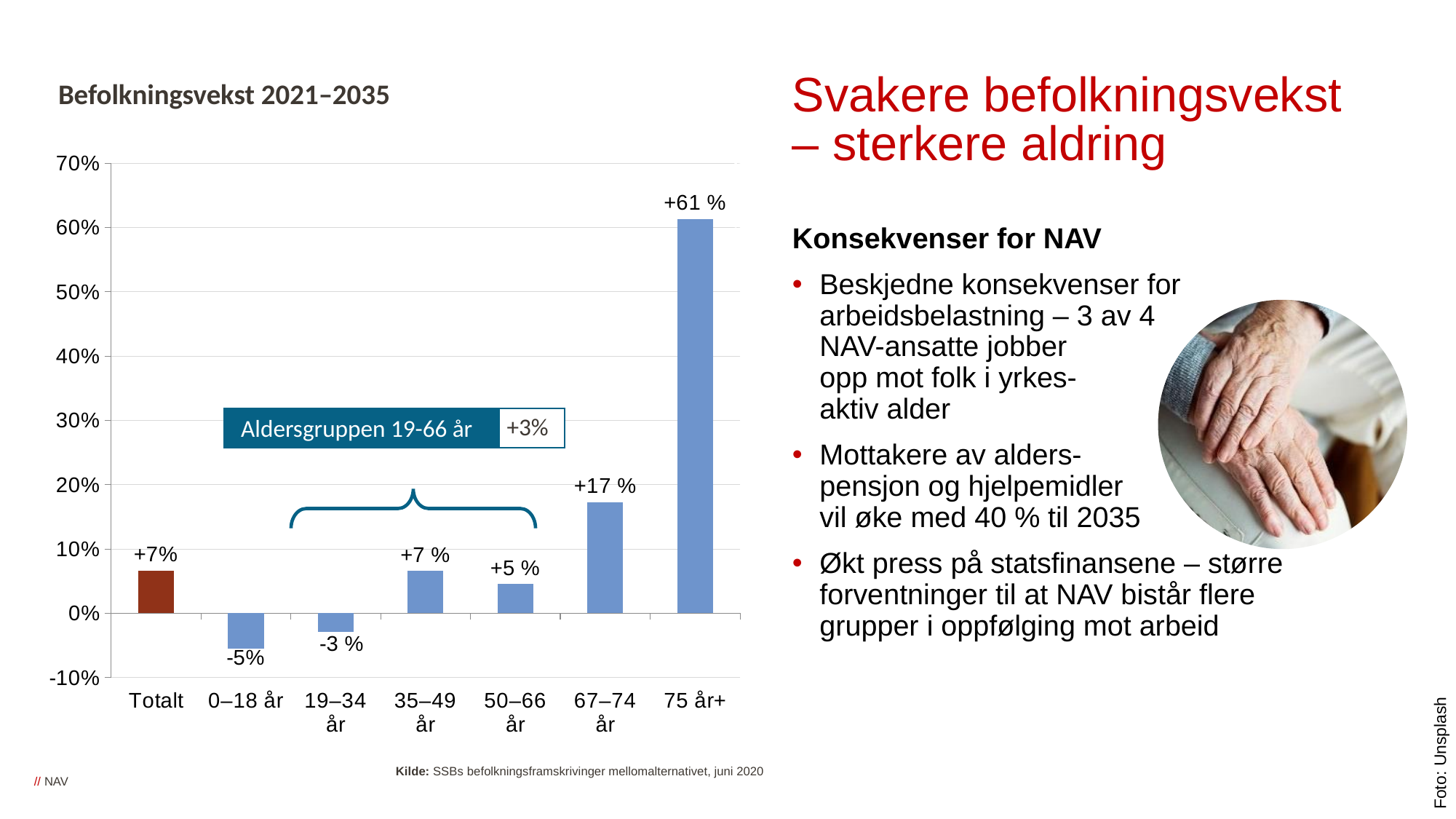
What is the difference in percentage points between the 75 år+ and 67–74 år values? 44 percentage points What is the value shown for the 0–18 år category? -5% Which category has the highest value in the chart? 75 år+ What is the value shown for the 67–74 år category? +17 % What kind of chart is shown on the slide? Bar chart Which category has the lowest value in the chart? 0–18 år What growth value does the annotation give for Aldersgruppen 19-66 år? +3% What is the value shown for the 75 år+ category? +61 % What is the value shown for the Totalt bar? +7% Which is larger, the value for 50–66 år or the value for 67–74 år? 67–74 år How many categories are shown on the x axis of the chart? 7 Is the value for 75 år+ greater or less than 60%? greater